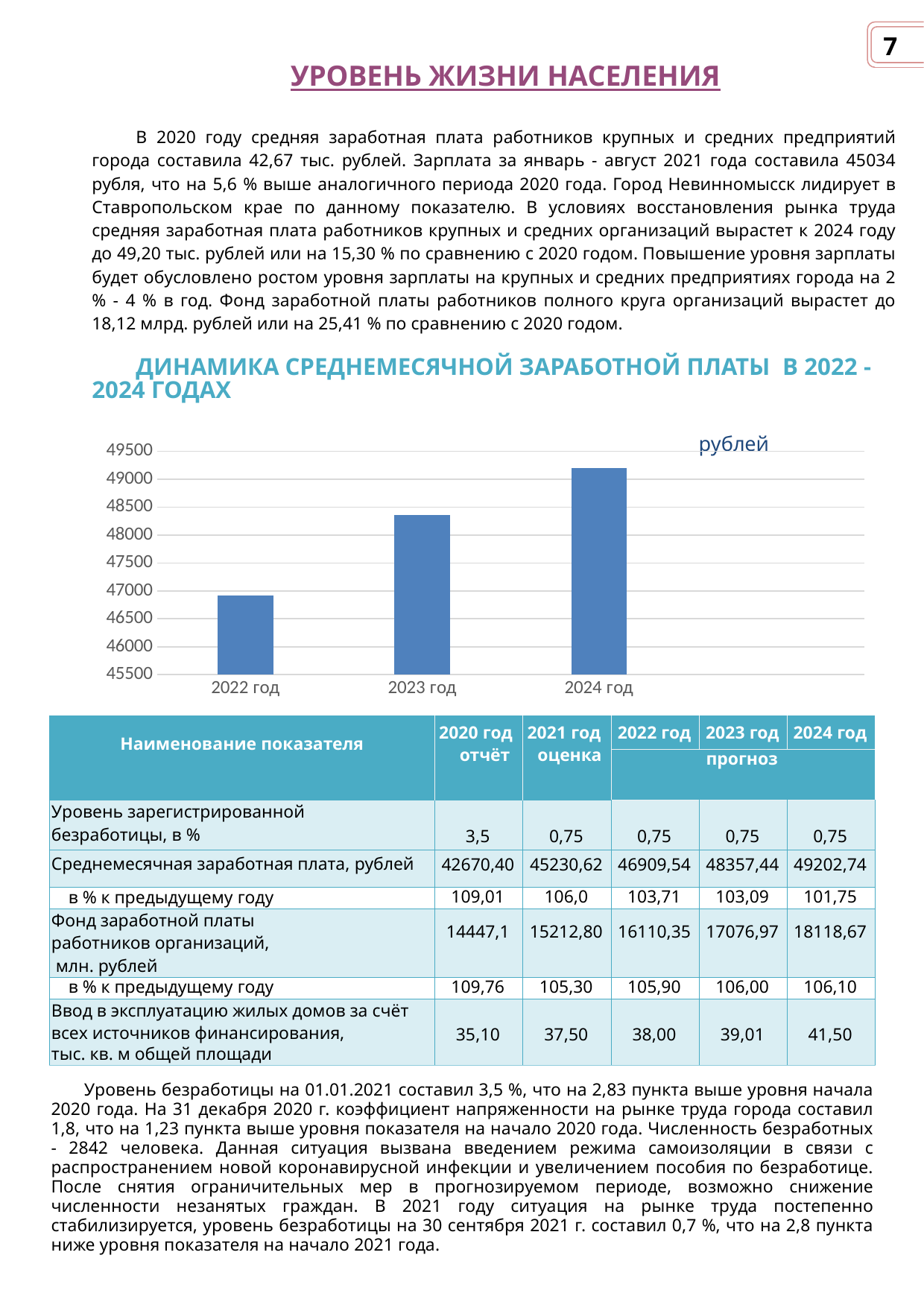
Is the value for 2022 год greater or less than 46500? greater Which is larger in the chart, the value for 2023 год or the value for 2024 год? 2024 год What kind of chart is shown under the title 'ДИНАМИКА СРЕДНЕМЕСЯЧНОЙ ЗАРАБОТНОЙ ПЛАТЫ В 2022 - 2024 ГОДАХ'? bar chart What unit label is shown at the top right of the chart? рублей Is the value for 2023 год greater or less than 48000? greater Is the value for 2024 год greater or less than 49000? greater Which year has the lowest bar in the chart? 2022 год How many bars (years) are plotted in the chart? 3 Do the values in the chart rise or fall from 2022 год to 2024 год? rise What is the lowest value shown on the chart's vertical axis? 45500 Which year has the highest bar in the chart? 2024 год